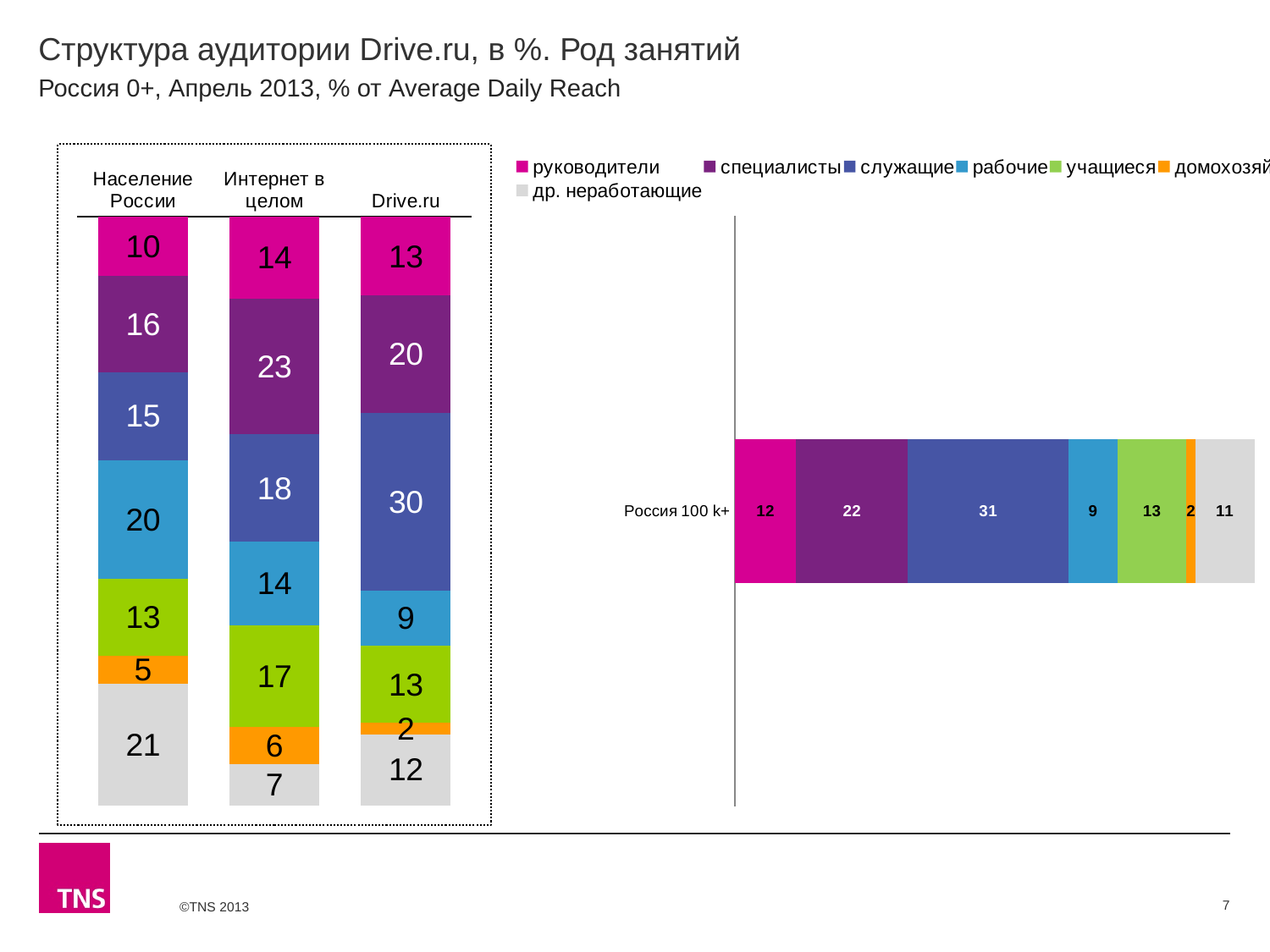
In the right chart (Россия 100 k+), what is the value of the служащие segment? 31 In the left stacked bar chart, what is the value of the др. неработающие segment for Население России? 21 What type of chart is shown on the right side of the slide? Stacked bar chart In the left stacked bar chart, which segment is the largest in the Drive.ru bar? служащие In the left stacked bar chart, which is larger: the рабочие value for Население России or for Drive.ru? Население России What is the total of the Население России bar in the left stacked bar chart? 100 In the left stacked bar chart, which segment is the smallest in the Drive.ru bar? домохозяйки How many bars (columns) does the left stacked bar chart contain? 3 In the right chart (Россия 100 k+), what is the value of the домохозяйки segment? 2 In the left stacked bar chart, what is the value of the служащие segment for Drive.ru? 30 In the left stacked bar chart, what is the difference between the служащие values for Drive.ru and Население России? 15 In the left stacked bar chart, what is the value of the специалисты segment for Интернет в целом? 23